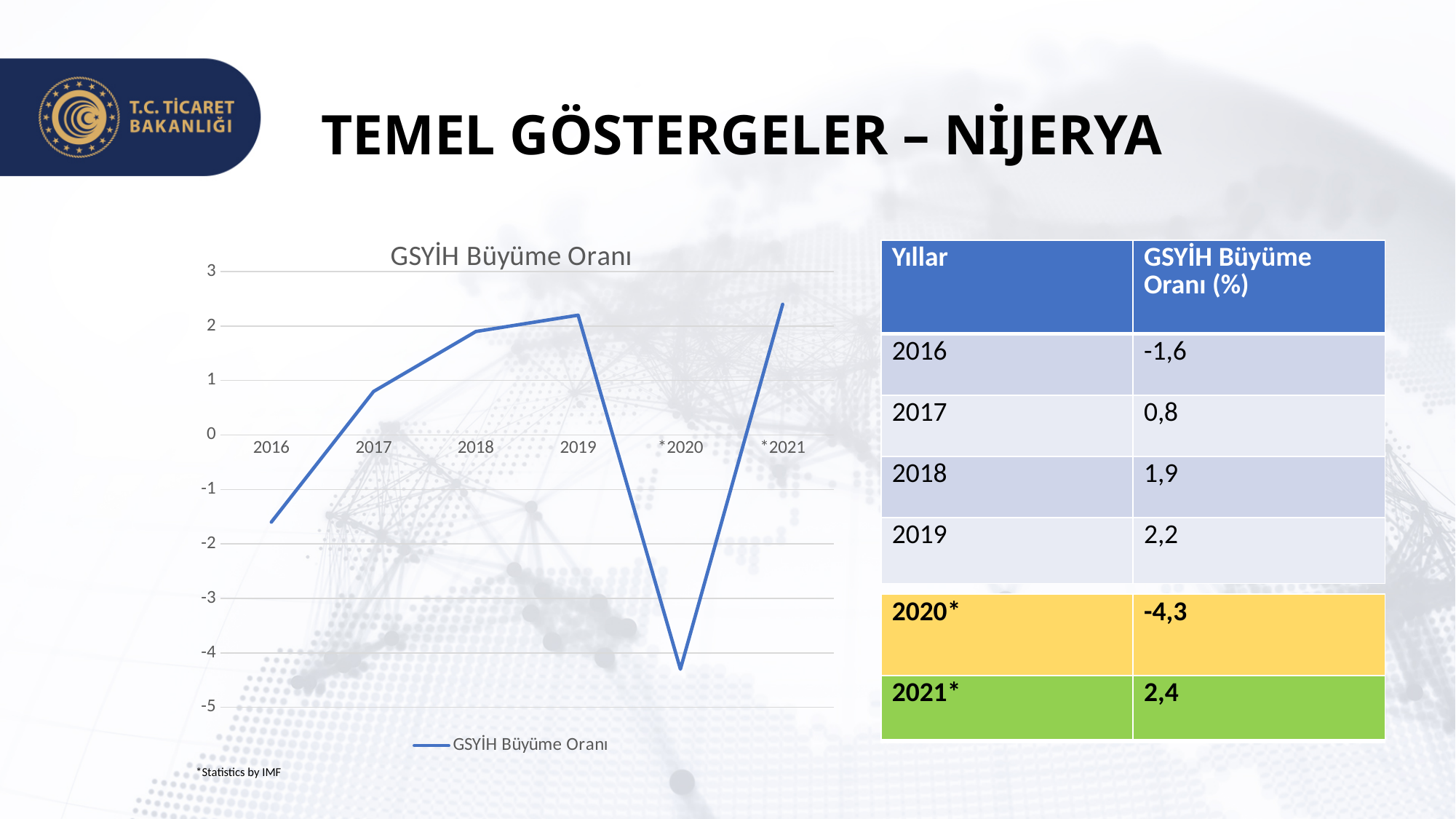
How many years are plotted on the x axis of the chart? 6 Which year has the highest GSYİH Büyüme Oranı value in the chart? 2021 How many series does the chart legend list? 1 What is the GSYİH Büyüme Oranı value for 2016? -1,6 Does the GSYİH Büyüme Oranı rise or fall from 2016 to 2019? rise Which is larger, the value for 2018 or the value for 2017? 2018 What is the GSYİH Büyüme Oranı value for 2020? -4,3 Is the value for 2019 greater or less than 2? greater Is the value for 2017 greater or less than 1? less What type of chart is shown on the slide? line chart Which year has the lowest GSYİH Büyüme Oranı value in the chart? 2020 What is the title of the chart? GSYİH Büyüme Oranı